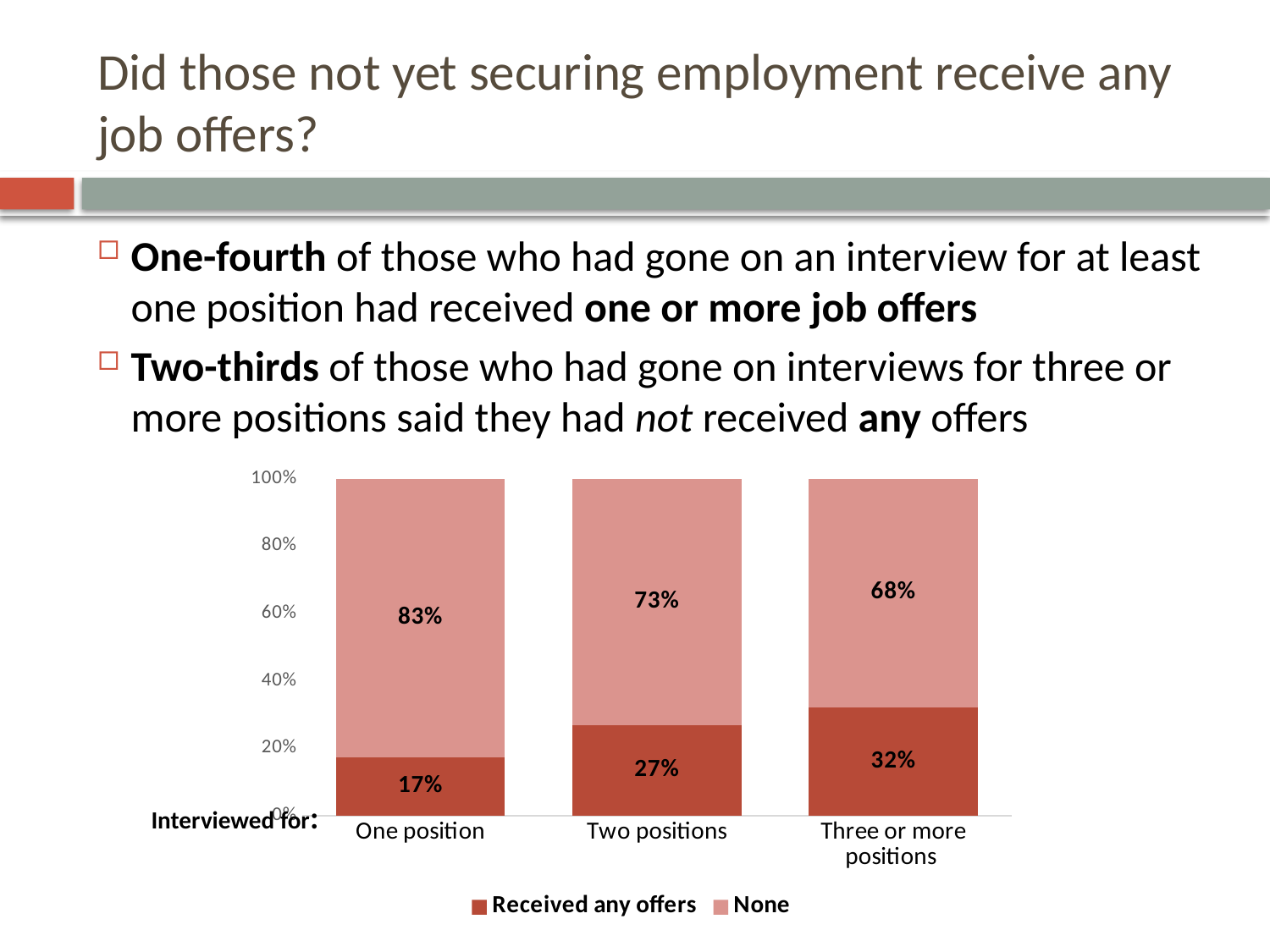
Does the 'Received any offers' share rise or fall from 'One position' to 'Three or more positions'? Rise Which is larger: the 'None' share for 'One position' or for 'Two positions'? One position How many series does the legend list? 2 What is the 'None' value for the 'Two positions' category? 73% What percentage of those interviewed for three or more positions received no offers? 68% What are the two series named in the legend? Received any offers; None How many categories are shown on the x axis? 3 What kind of chart is shown on the slide? Stacked bar chart Which category has the highest 'Received any offers' share? Three or more positions What percentage of those interviewed for one position received any offers? 17% What is the difference between the 'Received any offers' values for 'Three or more positions' and 'One position'? 15% Which category has the lowest 'None' share? Three or more positions